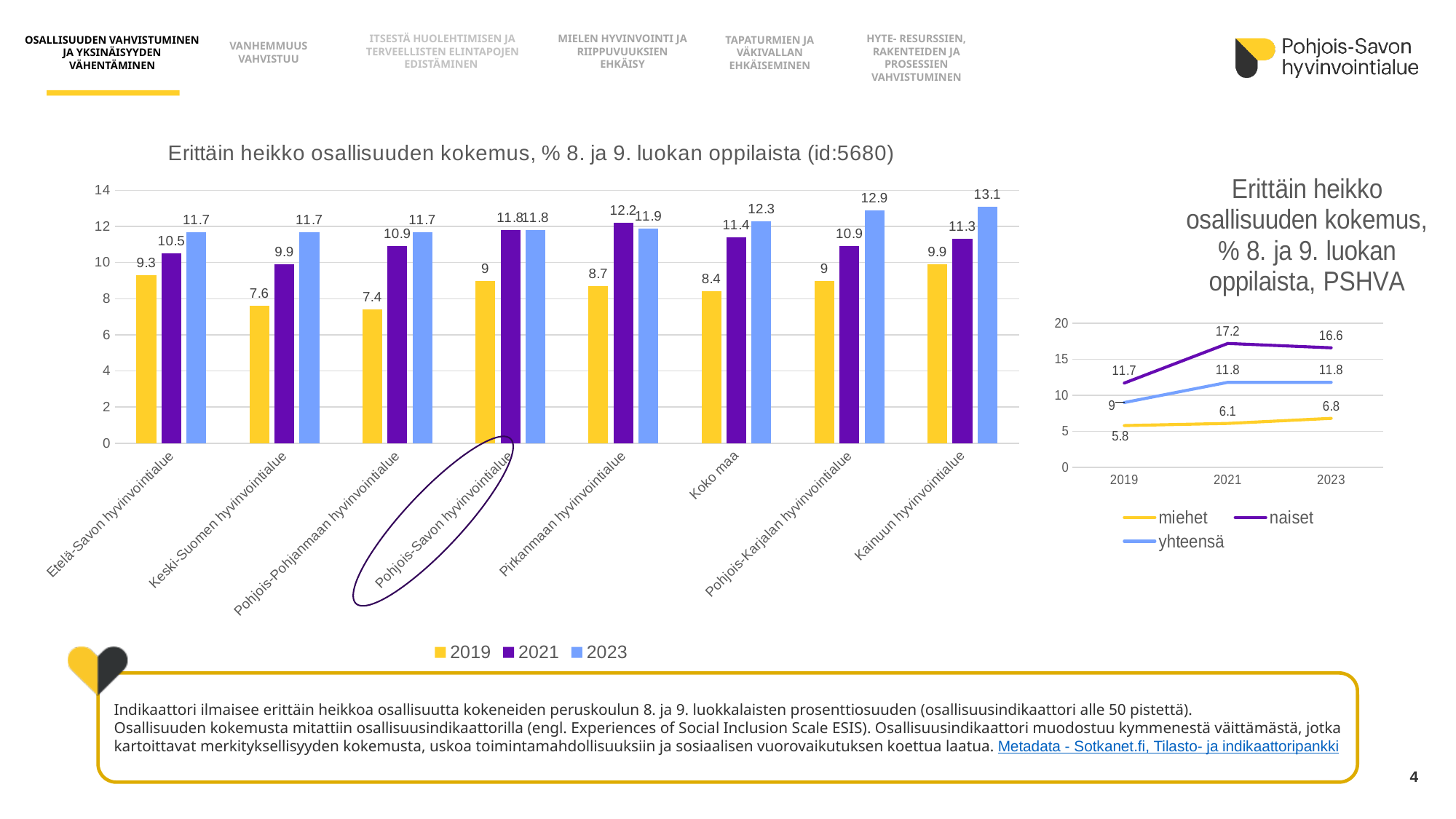
In the bar chart on the left, which is larger for Koko maa: the 2021 value or the 2023 value? 2023 In the bar chart on the left, which category has the highest 2023 value? Kainuun hyvinvointialue In the bar chart on the left, what is the 2023 value for Kainuun hyvinvointialue? 13.1 In the line chart on the right, what is the value for naiset in 2021? 17.2 In the line chart on the right, does the miehet series rise or fall from 2019 to 2023? Rise In the bar chart on the left, what is the 2019 value for Pohjois-Pohjanmaan hyvinvointialue? 7.4 How many series does the legend of the bar chart on the left list? 3 What kind of chart is the chart on the right of the slide? Line chart In the bar chart on the left, what is the difference between the 2021 and 2019 values for Pirkanmaan hyvinvointialue? 3.5 In the line chart on the right, what is the difference between naiset and miehet in 2023? 9.8 In the bar chart on the left, which category has the lowest 2019 value? Pohjois-Pohjanmaan hyvinvointialue How many categories are shown on the x axis of the bar chart on the left? 8